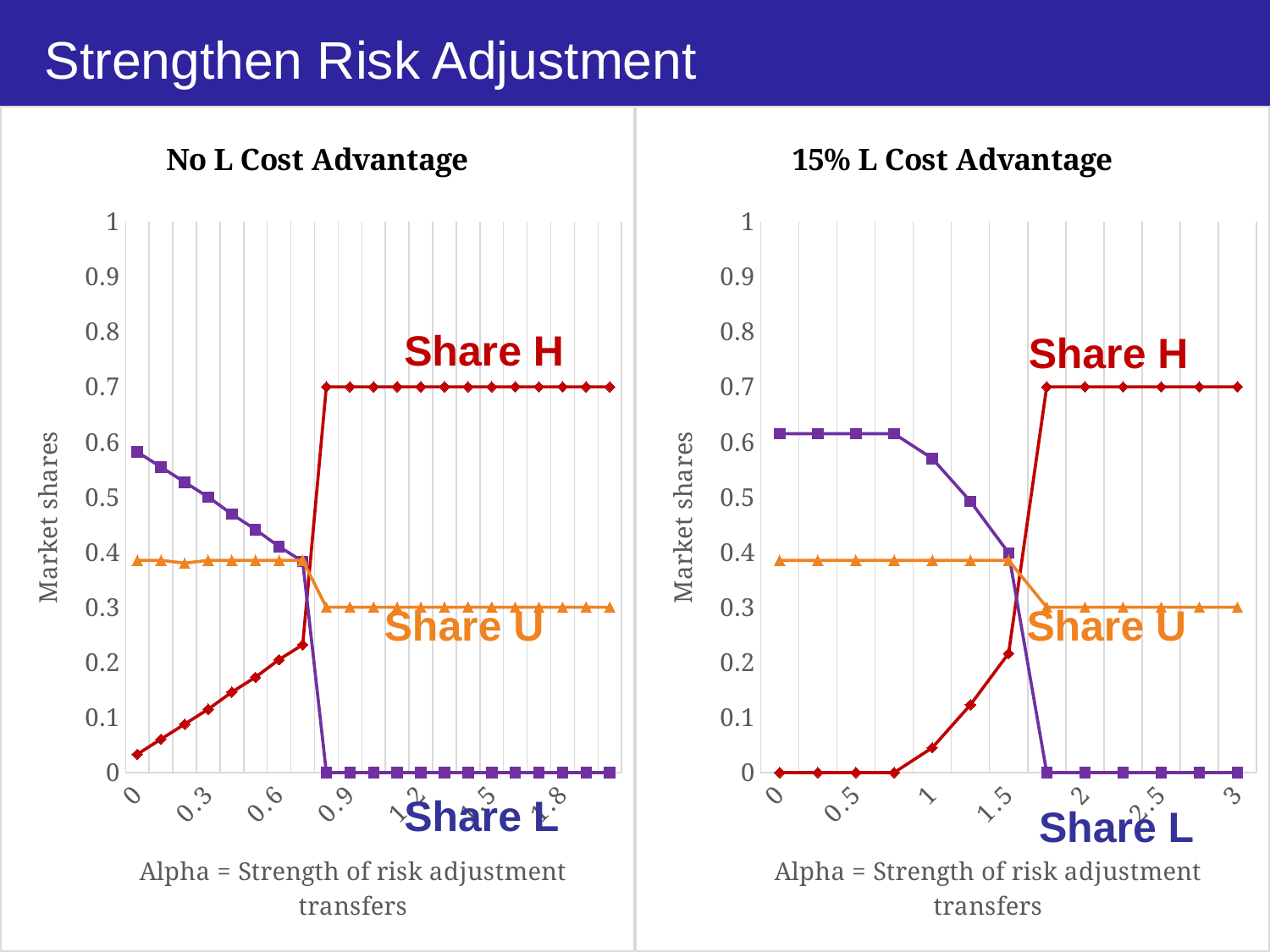
In the "15% L Cost Advantage" chart, what is the value of Share U at alpha 3? 0.3 In the "No L Cost Advantage" chart, what is the value of Share L at alpha 1.8? 0 In the "No L Cost Advantage" chart, at what value does Share U level off for large alpha? 0.3 In the "No L Cost Advantage" chart, does Share L rise or fall as alpha increases? fall What type of chart is the "No L Cost Advantage" chart? line chart In the "15% L Cost Advantage" chart, what is the value of Share H at alpha 0? 0 How many series are plotted in the "15% L Cost Advantage" chart? 3 In the "No L Cost Advantage" chart, is the value of Share L at alpha 0 greater or less than 0.5? greater In the "15% L Cost Advantage" chart, what is the value of Share H at alpha 3? 0.7 In the "No L Cost Advantage" chart, at what value does Share H level off for large alpha? 0.7 What is the y-axis title of the "No L Cost Advantage" chart? Market shares In the "15% L Cost Advantage" chart, which series has the highest value at alpha 3? Share H